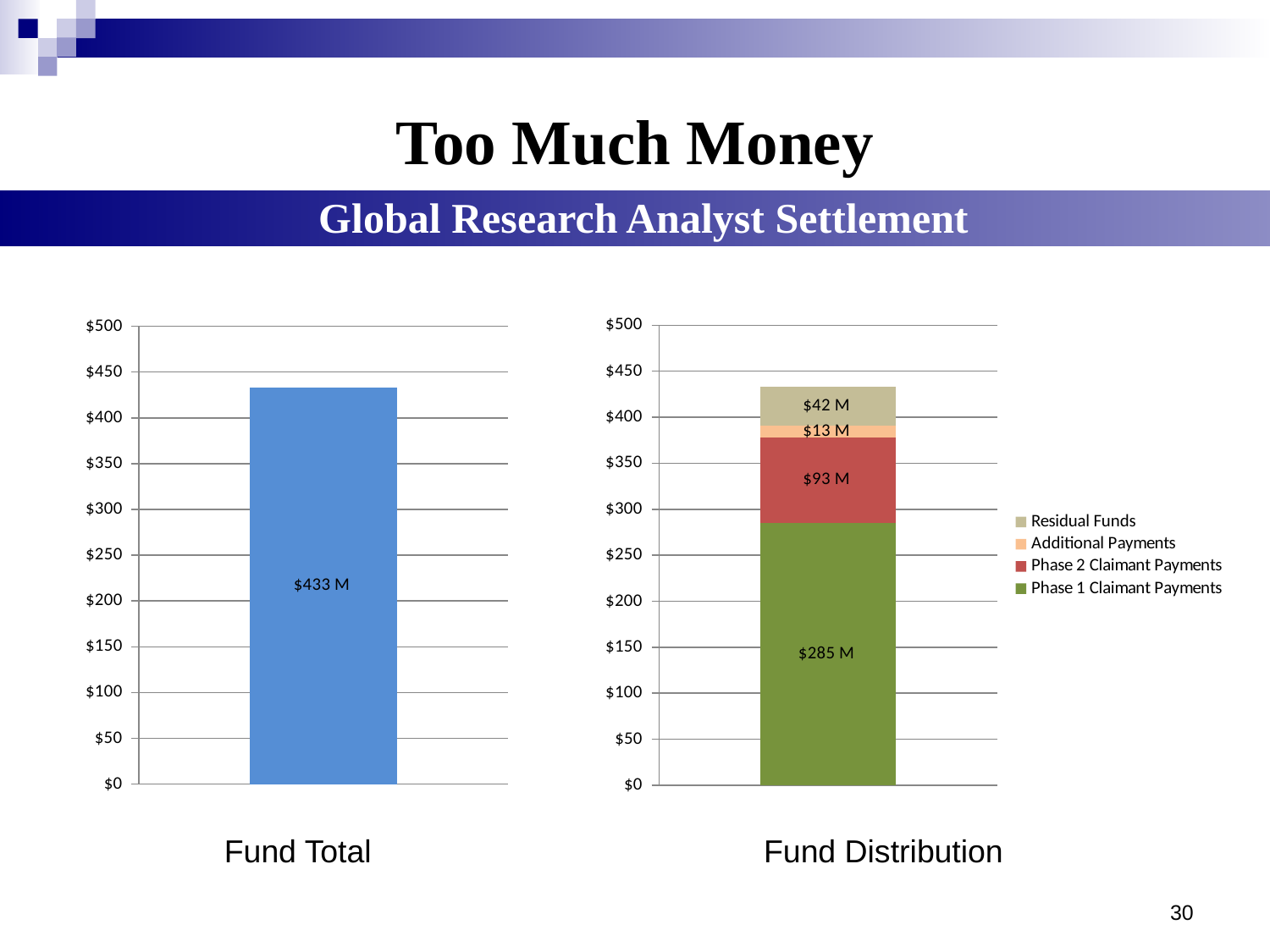
How many series does the legend of the Fund Distribution chart list? 4 In the Fund Distribution chart, which segment of the stacked bar is the smallest? Additional Payments In the Fund Distribution chart, which is larger: Residual Funds or Additional Payments? Residual Funds In the Fund Total chart, what is the value of the single bar? $433 M In the Fund Distribution chart, what is the value for Phase 2 Claimant Payments? $93 M In the Fund Distribution chart, what is the value for Additional Payments? $13 M In the Fund Distribution chart, what is the value for Phase 1 Claimant Payments? $285 M In the Fund Distribution chart, what is the value for Residual Funds? $42 M In the Fund Distribution chart, what is the difference between Phase 1 Claimant Payments and Phase 2 Claimant Payments? $192 M What kind of chart is the Fund Total chart? Bar chart In the Fund Distribution chart, which segment of the stacked bar is the largest? Phase 1 Claimant Payments In the Fund Distribution chart, what is the total of the stacked bar? $433 M